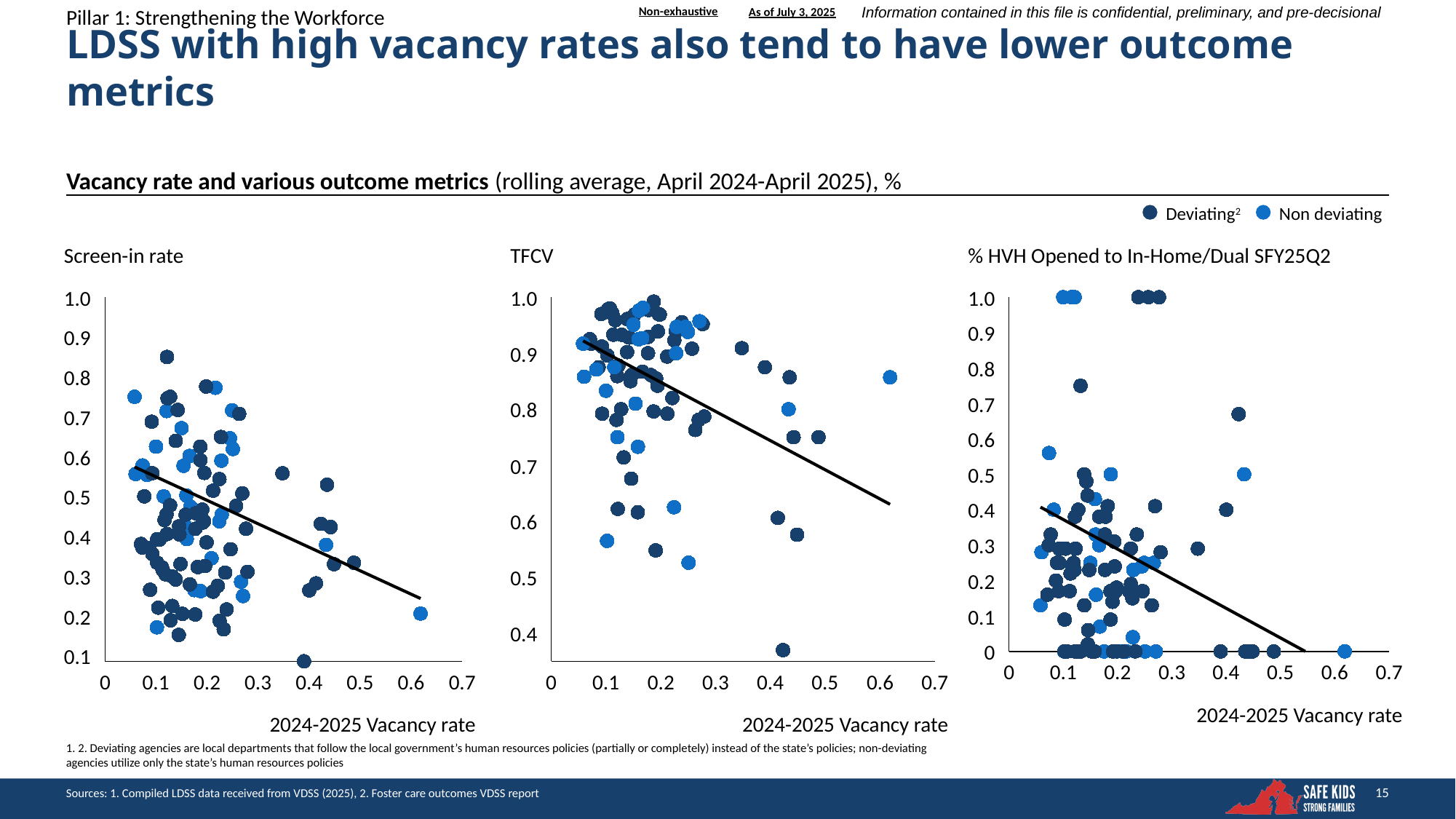
How many scatter charts are shown on the slide? 3 How many series does the legend list for the charts on this slide? 2 What is the x-axis label on the TFCV chart? 2024-2025 Vacancy rate In the TFCV chart, does the trend line rise or fall as the vacancy rate increases? Fall What kind of chart is the Screen-in rate chart? Scatter chart In the % HVH Opened to In-Home/Dual SFY25Q2 chart, is the value for the point with the highest vacancy rate greater or less than 0.1? less In the TFCV chart, is the value for the point with the highest vacancy rate greater or less than 0.8? greater In the Screen-in rate chart, is the value for the point with the highest vacancy rate greater or less than 0.3? less In the % HVH Opened to In-Home/Dual SFY25Q2 chart, does the trend line rise or fall along the x axis? Fall In the Screen-in rate chart, does the trend line rise or fall as the vacancy rate increases? Fall What is the highest tick value shown on the y axis of the TFCV chart? 1.0 What are the two series named in the legend? Deviating and Non deviating